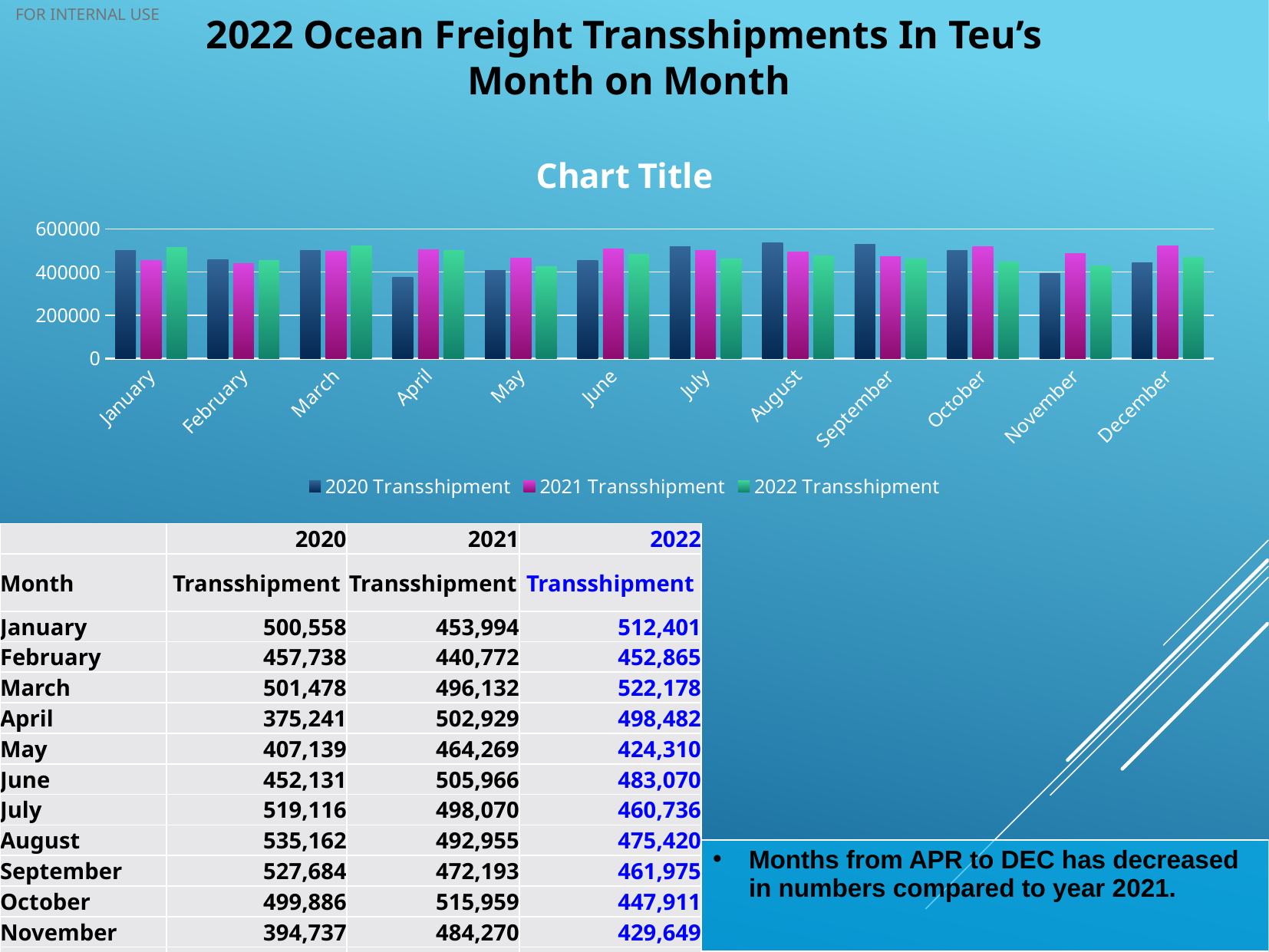
How many months are shown along the x axis of the chart? 12 Is the 2020 Transshipment value for April greater or less than 400000? less What title is displayed above the chart? Chart Title For August, which is larger: the 2020 Transshipment or the 2021 Transshipment? 2020 Transshipment What is the 2022 Transshipment value for January? 512,401 What is the 2020 Transshipment value for April? 375,241 What is the 2021 Transshipment value for October? 515,959 What kind of chart is shown on the slide? bar chart How many series does the chart legend list? 3 Which month has the lowest 2020 Transshipment value? April What is the difference between the 2021 Transshipment and the 2022 Transshipment for October? 68,048 Which month has the highest 2022 Transshipment value? March